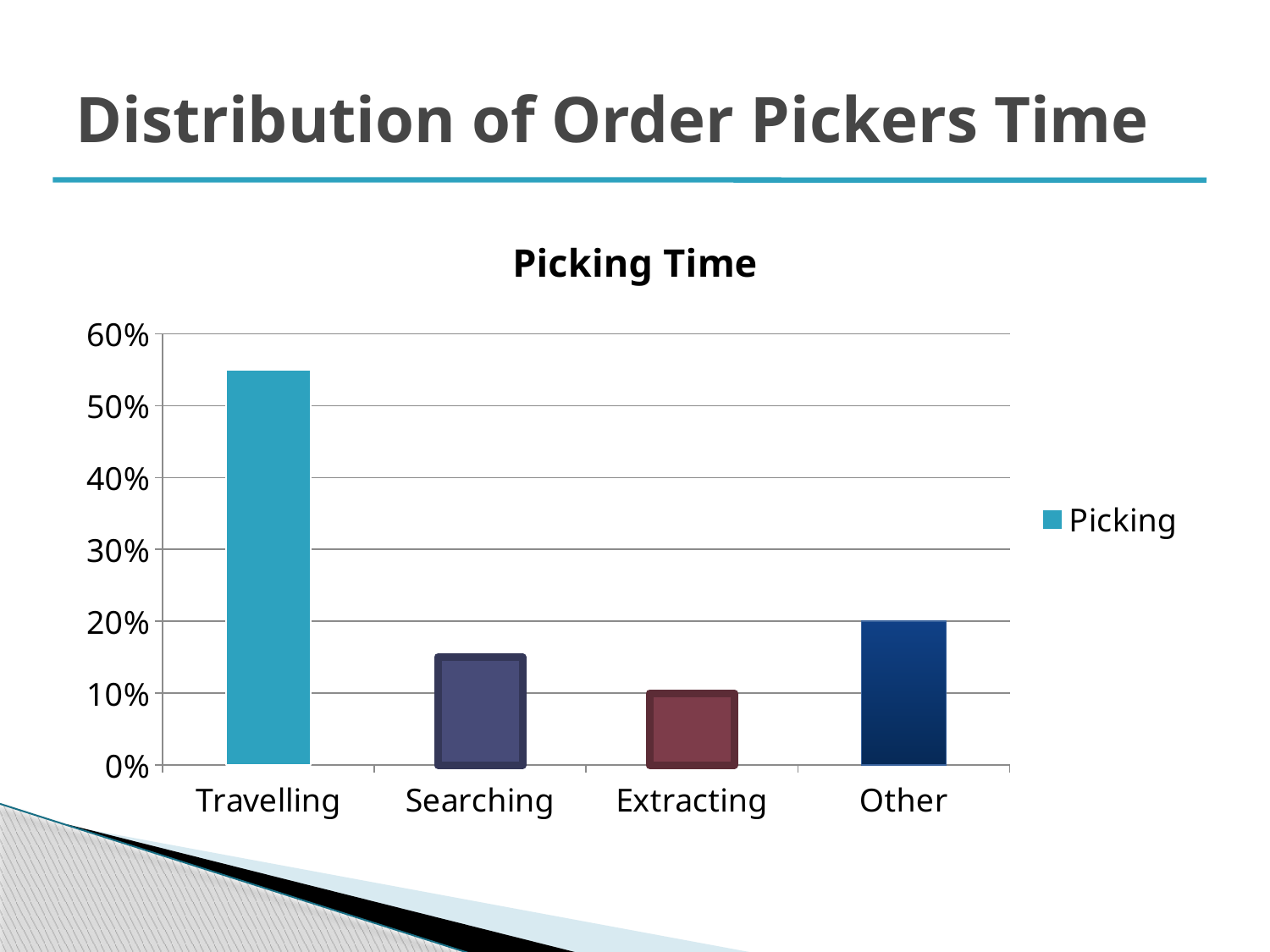
How many categories are shown on the x axis of the chart? 4 What type of chart is shown on the slide? bar chart Which category has the highest value? Travelling What is the title of the chart? Picking Time What is the name of the series shown in the legend? Picking Is the value for Travelling greater or less than 50%? greater Which is larger, the value for Other or the value for Searching? Other What is the value for Extracting? 10% Which category has the lowest value? Extracting How many series does the legend list? 1 Is the value for Searching greater or less than 20%? less What is the value for Other? 20%